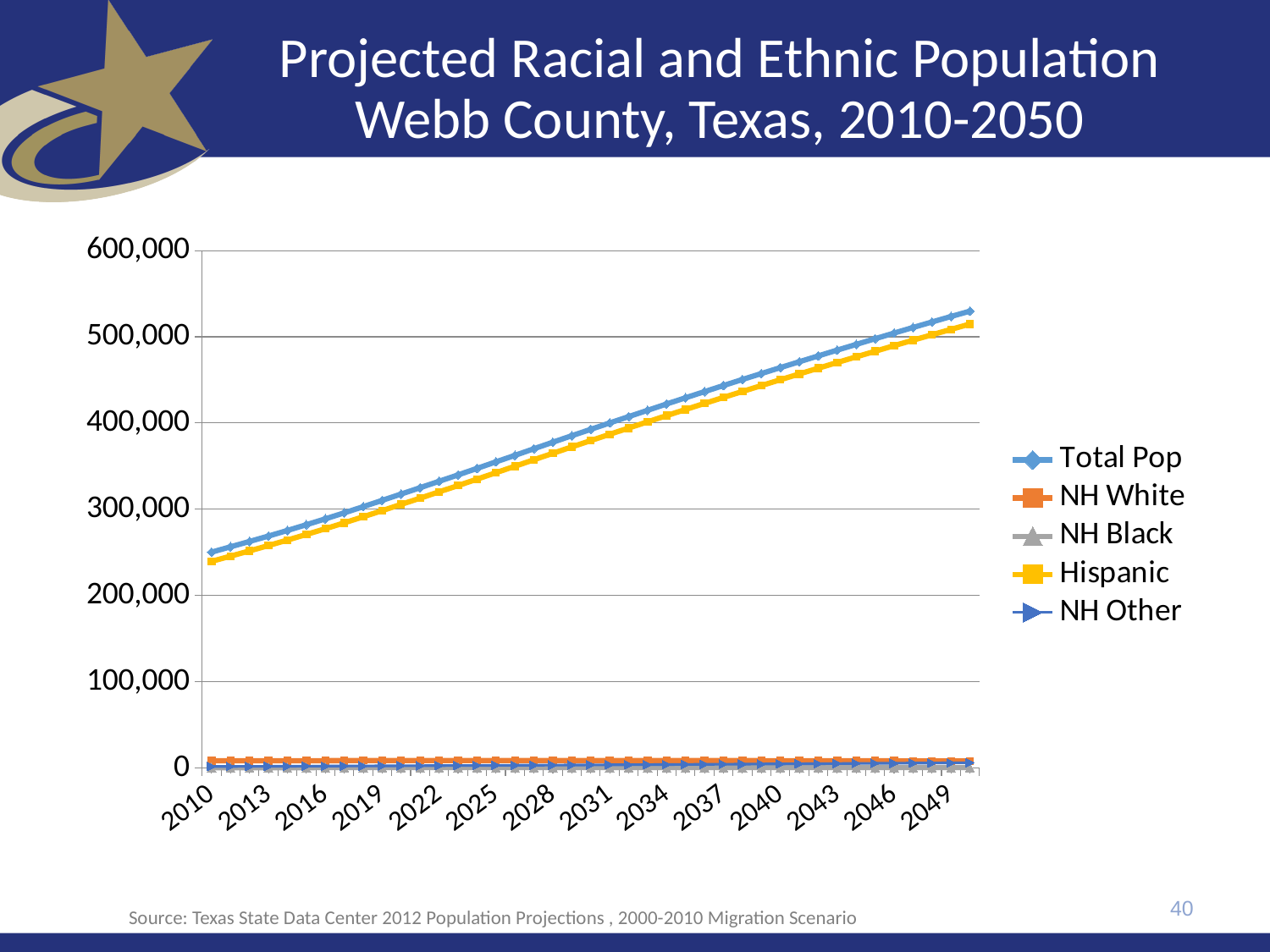
Is the value for Total Pop in 2049 greater or less than 500,000? greater Is the value for NH White in 2030 greater or less than 100,000? less What is the title of the chart on the slide? Projected Racial and Ethnic Population Webb County, Texas, 2010-2050 In 2030, which is larger, Total Pop or Hispanic? Total Pop Does the Total Pop line rise or fall from 2010 to 2050? rises Is the value for Hispanic in 2010 greater or less than 300,000? less How many series does the legend list? 5 Which series has the highest values across the chart? Total Pop In 2040, which is larger, Hispanic or NH White? Hispanic What kind of chart is shown on the slide? line chart Does the Hispanic line rise or fall from 2010 to 2050? rises